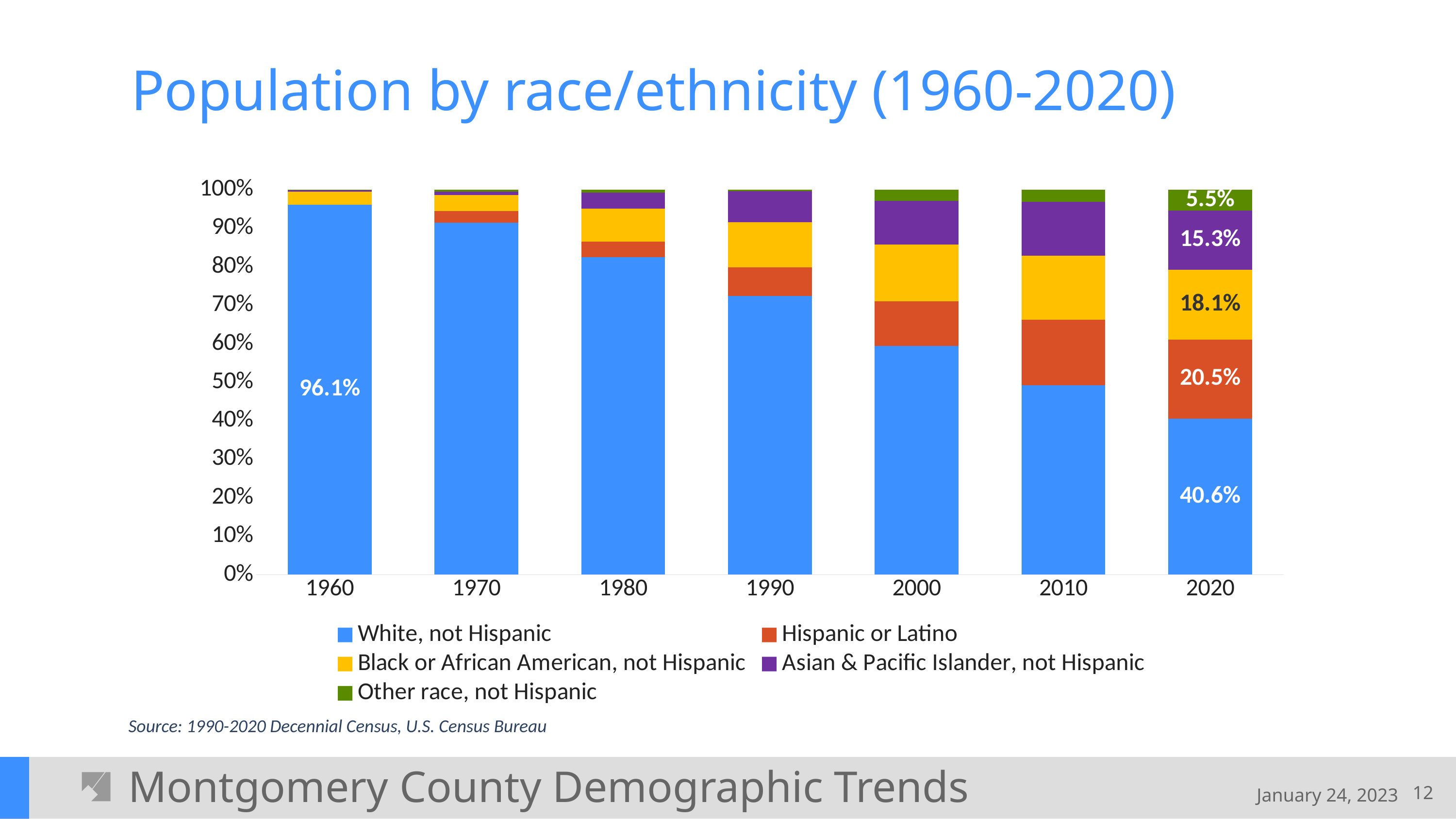
What share of the population was Hispanic or Latino in 2020? 20.5% Is the White, not Hispanic share in 2010 greater or less than 60%? less What share of the population was White, not Hispanic in 1960? 96.1% What share of the population was Other race, not Hispanic in 2020? 5.5% What share of the population was White, not Hispanic in 2020? 40.6% By how many percentage points did the White, not Hispanic share fall between 1960 and 2020? 55.5 In 2020, which was larger: the Hispanic or Latino share or the Asian & Pacific Islander, not Hispanic share? Hispanic or Latino How many years (bars) are shown on the x axis? 7 How many series does the legend list? 5 What share of the population was Asian & Pacific Islander, not Hispanic in 2020? 15.3% What share of the population was Black or African American, not Hispanic in 2020? 18.1% Does the White, not Hispanic share rise or fall from 1960 to 2020? fall